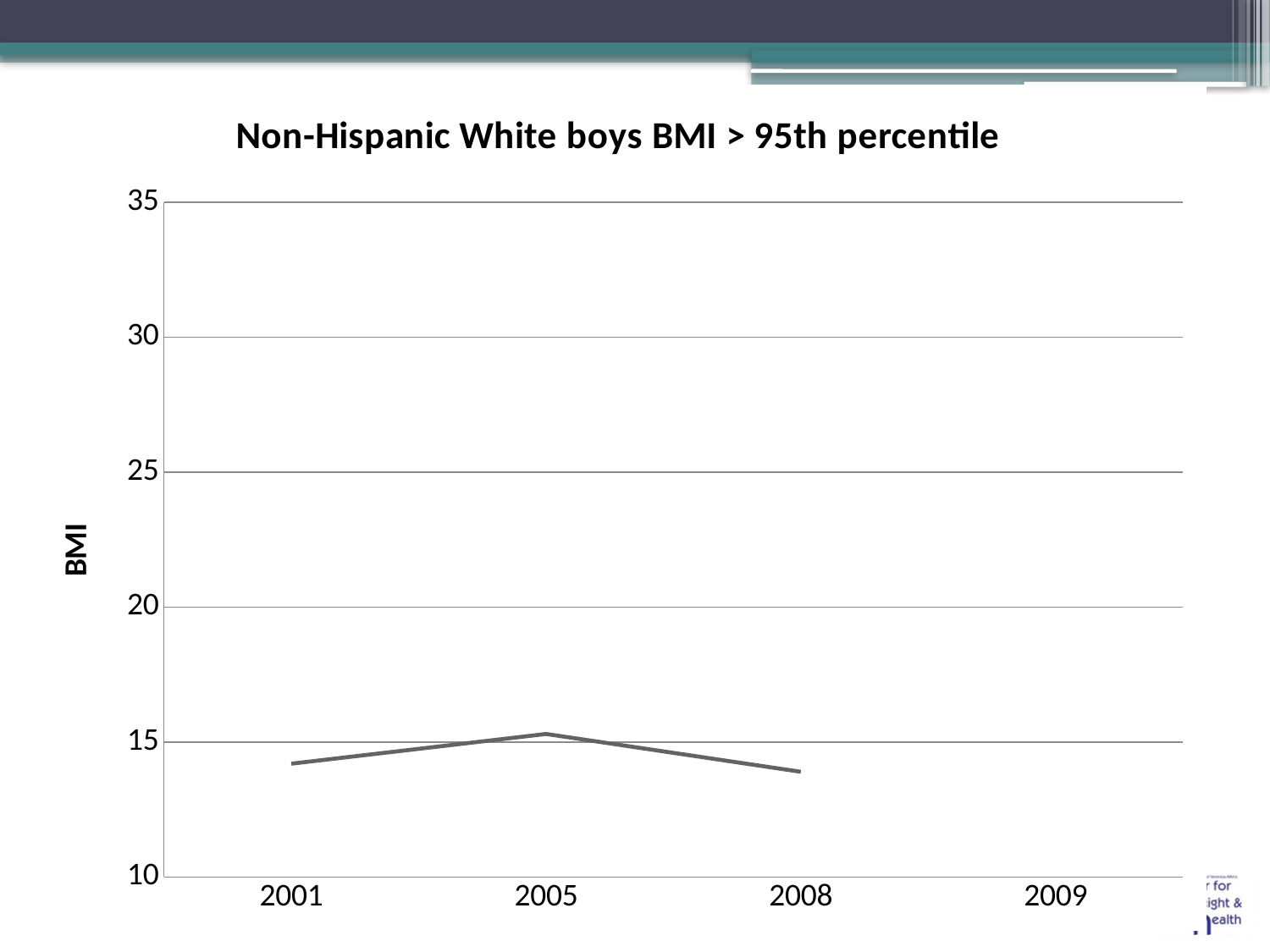
Does the line rise or fall from 2005 to 2008? fall Is the value for 2008 greater or less than 15? less Which year has the highest plotted value? 2005 Which is larger, the value for 2005 or the value for 2008? 2005 Does the line rise or fall from 2001 to 2005? rise What kind of chart is shown on the slide? line chart Is the value for 2005 greater or less than 15? greater Is the value for 2001 greater or less than 15? less What is the title of the chart? Non-Hispanic White boys BMI > 95th percentile How many years are labeled on the x axis? 4 What is the label on the vertical axis of the chart? BMI